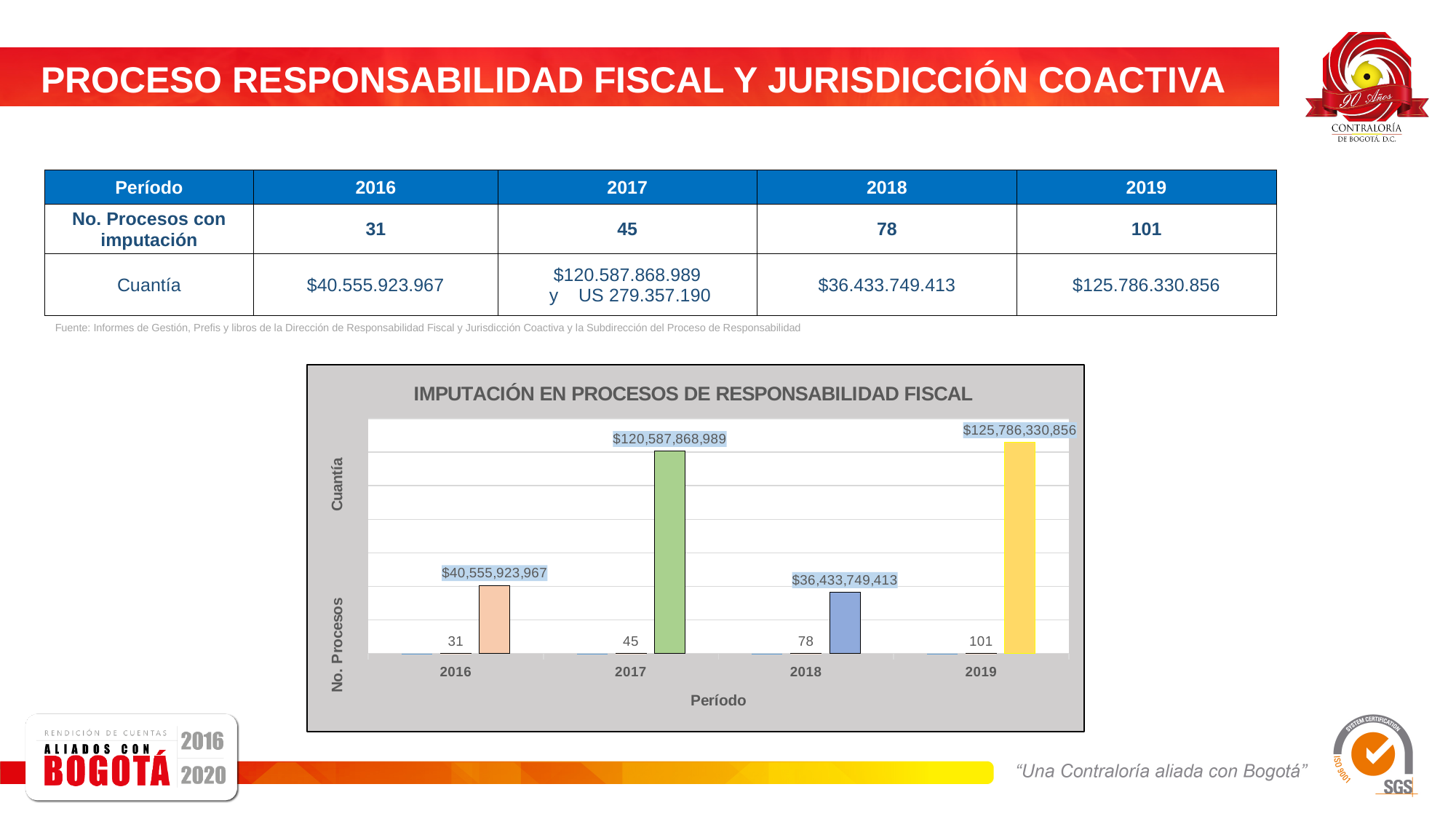
What is the title of the chart? IMPUTACIÓN EN PROCESOS DE RESPONSABILIDAD FISCAL What is the Cuantía value for 2018 in the chart? $36,433,749,413 Is the Cuantía for 2016 larger or smaller than the Cuantía for 2018? larger Which period has the highest Cuantía in the chart? 2019 What type of chart is shown on the slide? bar chart What is the No. Procesos value for 2019 in the chart? 101 Which period has the lowest No. Procesos in the chart? 2016 Which period has the lowest Cuantía in the chart? 2018 How many periods are shown on the x axis of the chart? 4 What is the Cuantía value for 2017 in the chart? $120,587,868,989 What is the difference in No. Procesos between 2019 and 2018? 23 What is the No. Procesos value for 2016 in the chart? 31